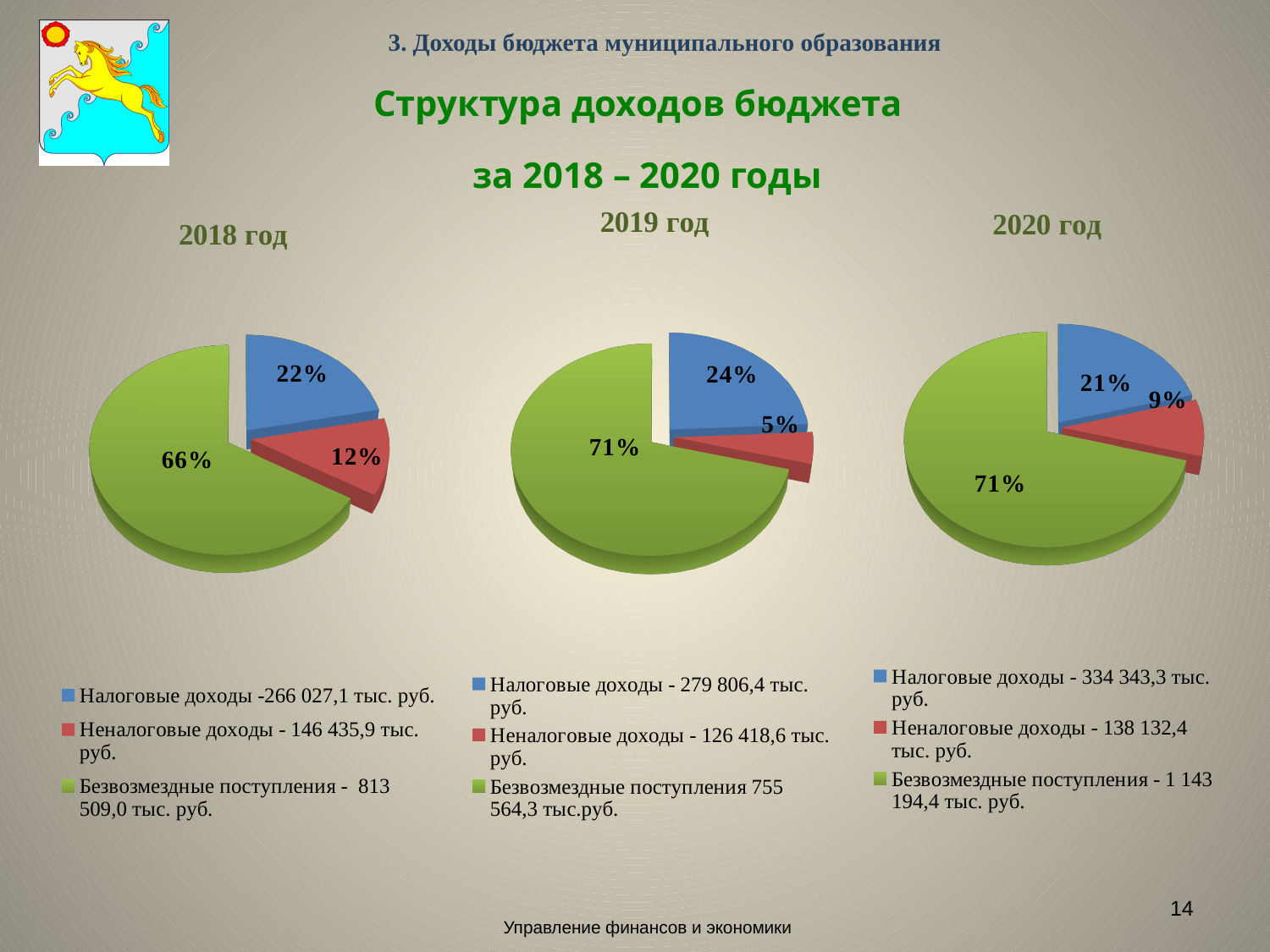
Which is larger: the Неналоговые доходы share in the 2018 год chart or in the 2020 год chart? 2018 год In the 2018 год pie chart, what share is labelled for Налоговые доходы? 22% According to the legend of the 2019 год chart, what is the amount for Налоговые доходы? 279 806,4 тыс. руб. In the 2020 год pie chart, which category has the largest slice? Безвозмездные поступления In the 2018 год pie chart, what is the difference in percentage points between the Безвозмездные поступления slice and the Налоговые доходы slice? 44 In the 2018 год pie chart, what share is labelled for Безвозмездные поступления? 66% In the 2019 год pie chart, which category has the smallest slice? Неналоговые доходы In the 2019 год pie chart, what share is labelled for Неналоговые доходы? 5% What type of chart is used to show the budget revenue structure for each year? Pie chart According to the legend of the 2020 год chart, what is the amount for Безвозмездные поступления? 1 143 194,4 тыс. руб. How many slices does the 2019 год pie chart have? 3